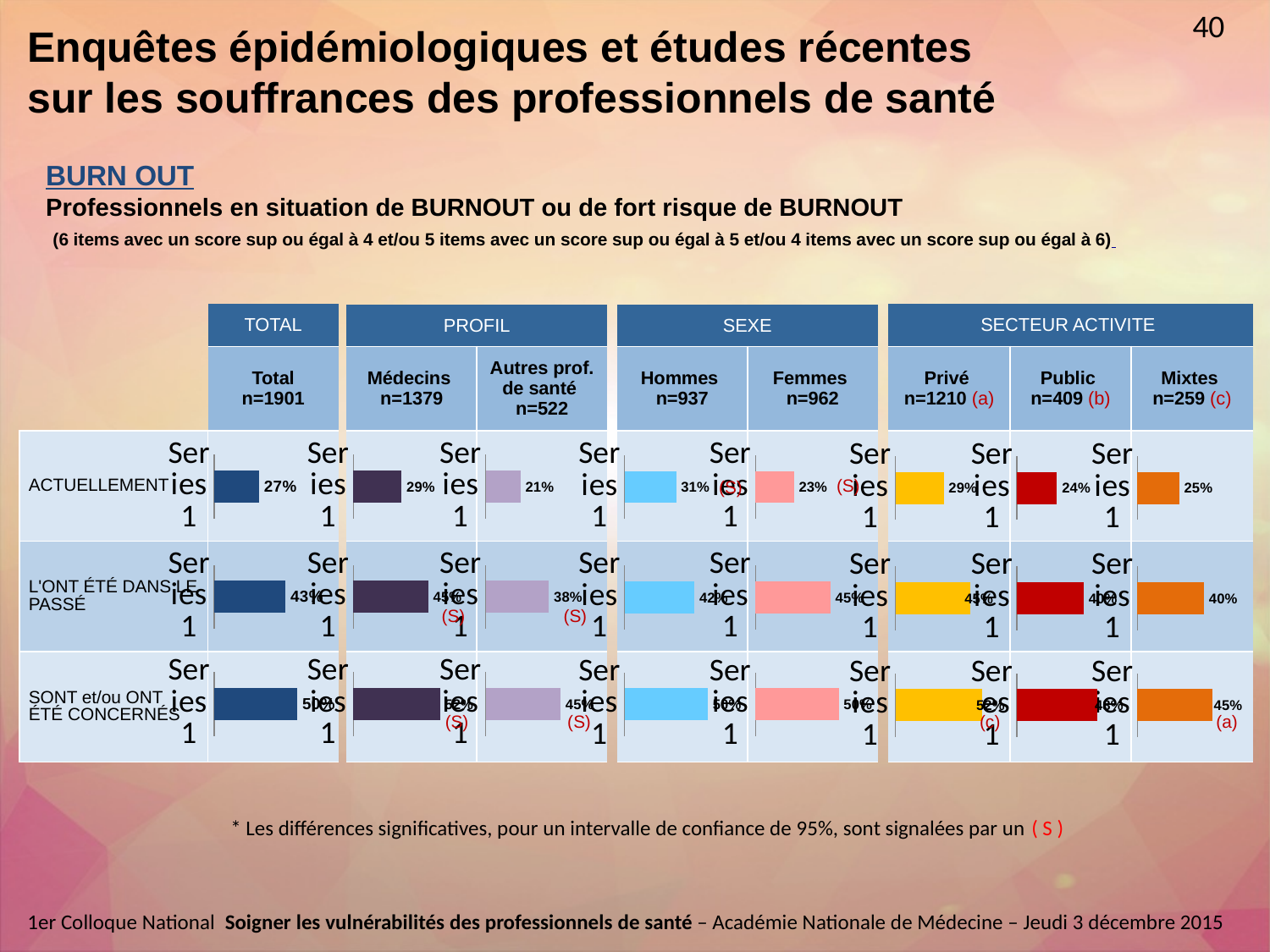
In the ACTUELLEMENT row, what is the difference between the Hommes and Femmes values? 8 percentage points In the ACTUELLEMENT row, what is the value shown for Hommes? 31% What kind of chart is used in each cell of the table? Bar chart In the L'ONT ÉTÉ DANS LE PASSÉ row, what is the value shown for Mixtes? 40% In the ACTUELLEMENT row, which group has the highest value? Hommes In the ACTUELLEMENT row, which group has the lowest value? Autres prof. de santé In the ACTUELLEMENT row, what is the value shown for Total (n=1901)? 27% In the ACTUELLEMENT row, which is larger: the value for Médecins or for Autres prof. de santé? Médecins How many group columns (Total, Médecins, etc.) are shown in the table? 8 In the L'ONT ÉTÉ DANS LE PASSÉ row, what is the value shown for Total? 43% In the SONT et/ou ONT ÉTÉ CONCERNÉS row, what is the value shown for Autres prof. de santé? 45% In the ACTUELLEMENT row, what is the value shown for Autres prof. de santé? 21%